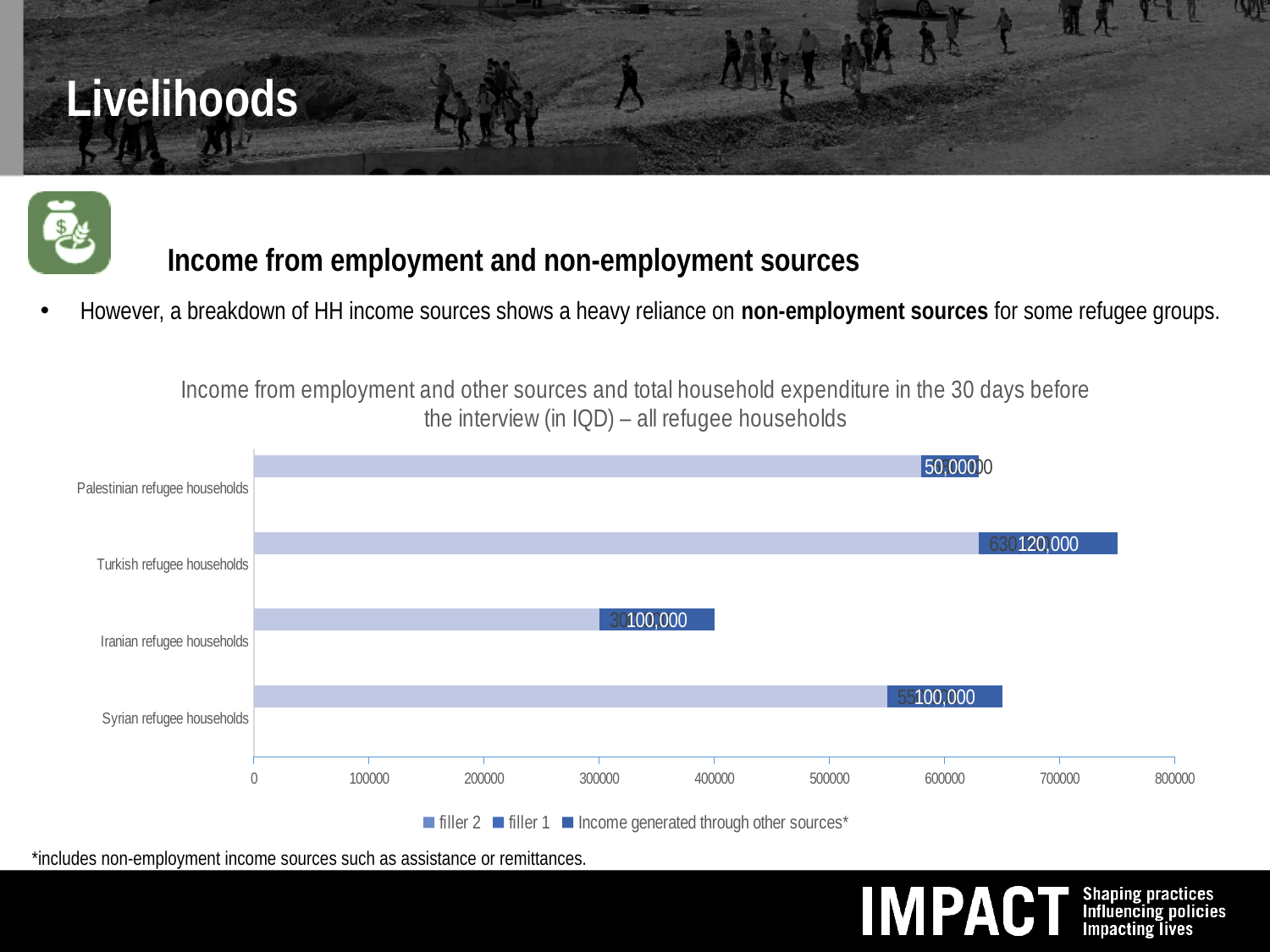
What type of chart is shown on the slide? bar chart What is the value of 'Income generated through other sources*' for Palestinian refugee households? 50,000 What is the difference between the 'Income generated through other sources*' values for Turkish refugee households and Palestinian refugee households? 70,000 How many series does the chart legend list? 3 Which refugee household category has the shortest total bar? Iranian refugee households What is the value of 'Income generated through other sources*' for Turkish refugee households? 120,000 How many refugee household categories are shown on the chart? 4 Which has a larger value for 'Income generated through other sources*': Turkish refugee households or Palestinian refugee households? Turkish refugee households Is the total bar length for Iranian refugee households greater or less than 500000? less What is the value of 'Income generated through other sources*' for Iranian refugee households? 100,000 What is the value of 'Income generated through other sources*' for Syrian refugee households? 100,000 Which refugee household category has the longest total bar? Turkish refugee households